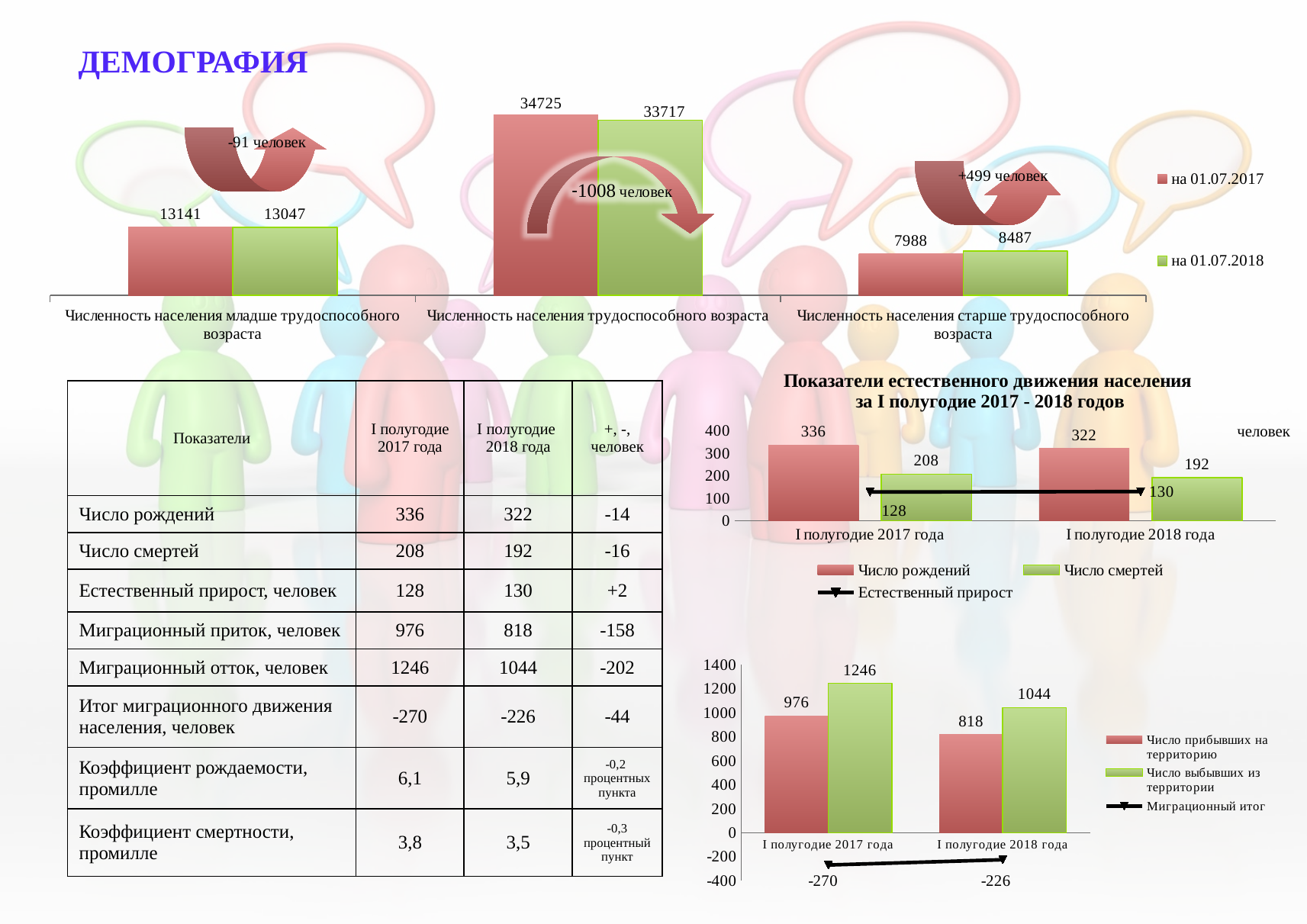
In the top population chart, how many series does the legend list? 2 In the bottom-right migration chart, what is the value of 'Число выбывших из территории' for I полугодие 2017 года? 1246 In the top population chart, which category has the highest values? Численность населения трудоспособного возраста In the chart 'Показатели естественного движения населения за I полугодие 2017 - 2018 годов', is 'Число рождений' for I полугодие 2017 года greater or less than 300? greater In the bottom-right migration chart, which is larger for I полугодие 2018 года: 'Число прибывших на территорию' or 'Число выбывших из территории'? Число выбывших из территории In the chart 'Показатели естественного движения населения за I полугодие 2017 - 2018 годов', does 'Число рождений' rise or fall from I полугодие 2017 года to I полугодие 2018 года? fall In the chart 'Показатели естественного движения населения за I полугодие 2017 - 2018 годов', what is the value of 'Число смертей' for I полугодие 2018 года? 192 In the chart 'Показатели естественного движения населения за I полугодие 2017 - 2018 годов', what is the value of 'Естественный прирост' for I полугодие 2017 года? 128 In the bottom-right migration chart, what is the value of 'Миграционный итог' for I полугодие 2018 года? -226 In the top population chart, what is the value for 'Численность населения старше трудоспособного возраста' on 01.07.2017? 7988 In the top population chart, what is the difference between the 01.07.2017 and 01.07.2018 values for 'Численность населения младше трудоспособного возраста'? 94 In the top population chart, what is the value for 'Численность населения трудоспособного возраста' on 01.07.2018? 33717